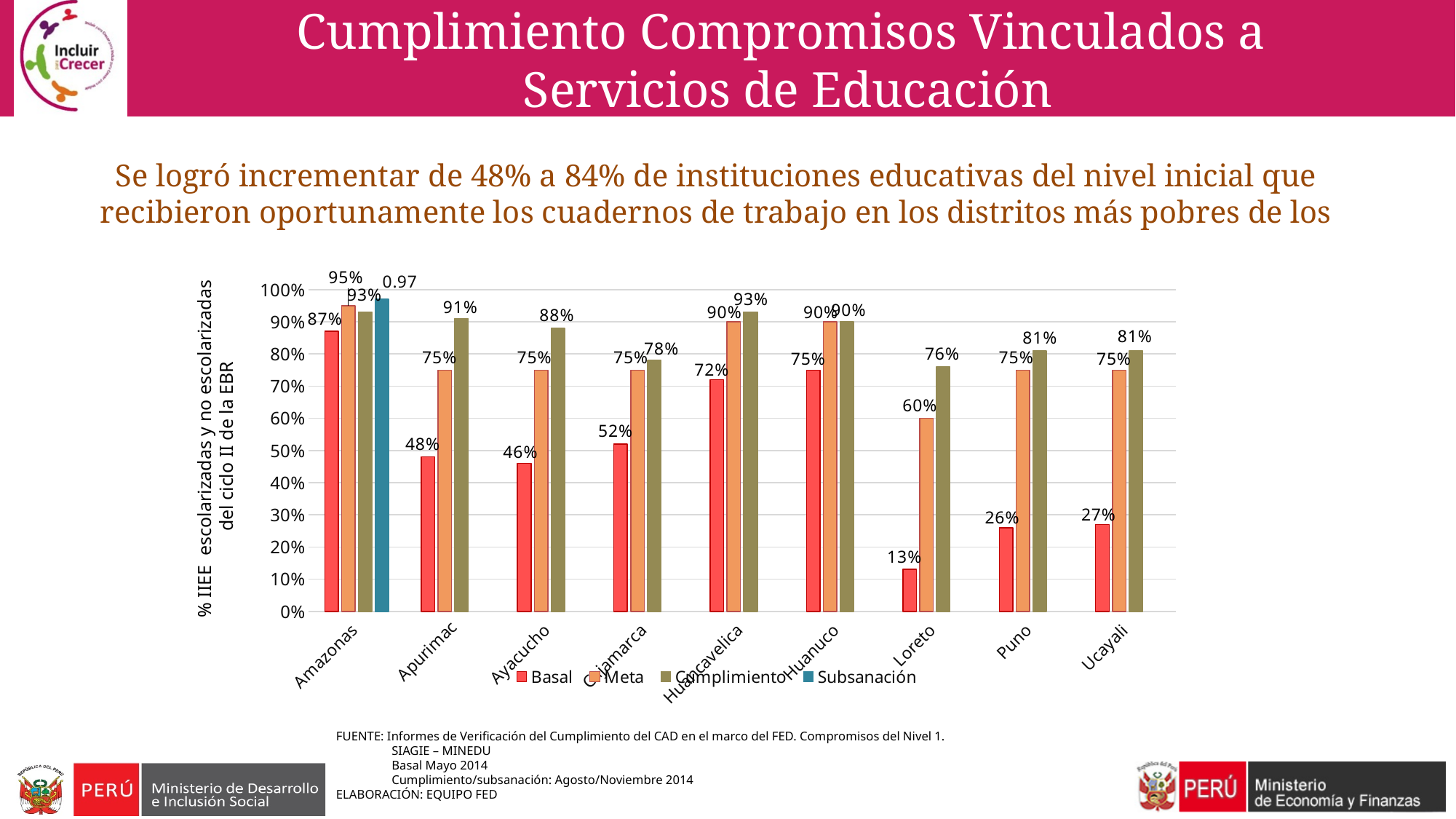
Which region has the lowest Basal value? Loreto What is the Cumplimiento value for Apurimac? 91% What kind of chart is shown on the slide? Bar chart What is the Subsanación value shown for Amazonas? 0.97 What is the difference between the Cumplimiento and Basal values for Loreto? 63 percentage points Which region has the highest Basal value? Amazonas How many series does the legend list? 4 Which region has a higher Cumplimiento value, Ayacucho or Cajamarca? Ayacucho What is the Basal value for Loreto? 13% Which region has the lowest Cumplimiento value? Loreto How many regions are shown on the x axis? 9 What is the Meta value for Huancavelica? 90%